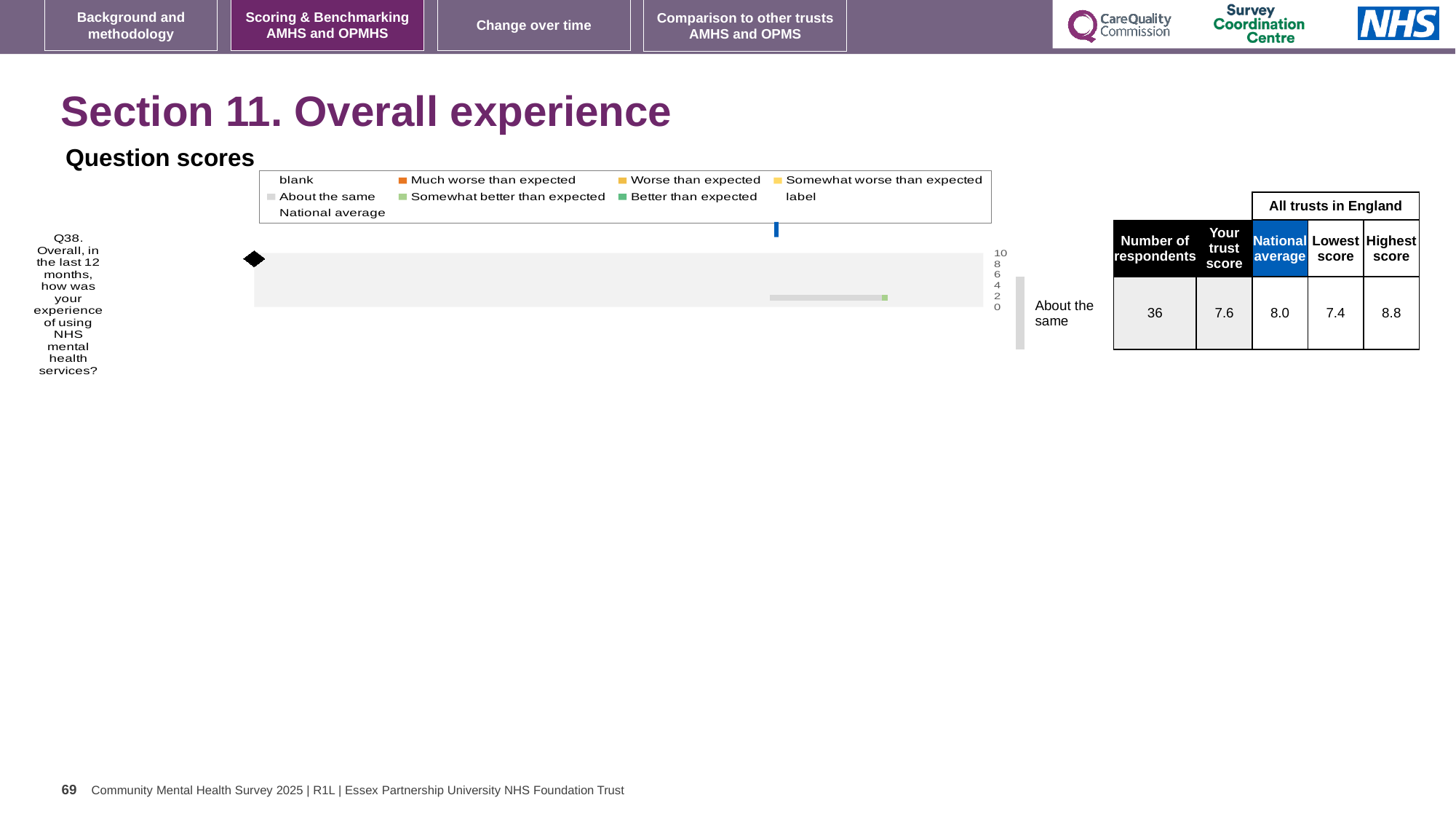
What is the national average score for Q38 shown alongside the chart? 8.0 What is the trust score for Q38 shown alongside the chart? 7.6 What is the highest value shown on the score axis of the Question scores chart? 10 How many questions (categories) are plotted in the Question scores chart? 1 What kind of chart is shown under "Question scores"? bar chart How many respondents answered Q38? 36 What benchmark category label is shown next to the bar for Q38? About the same What is the highest score among all trusts in England for Q38? 8.8 Is the trust score for Q38 higher or lower than the national average? lower What is the lowest score among all trusts in England for Q38? 7.4 What is the difference between the highest score and the lowest score for Q38 across all trusts in England? 1.4 Which question is plotted in the Question scores chart? Q38. Overall, in the last 12 months, how was your experience of using NHS mental health services?